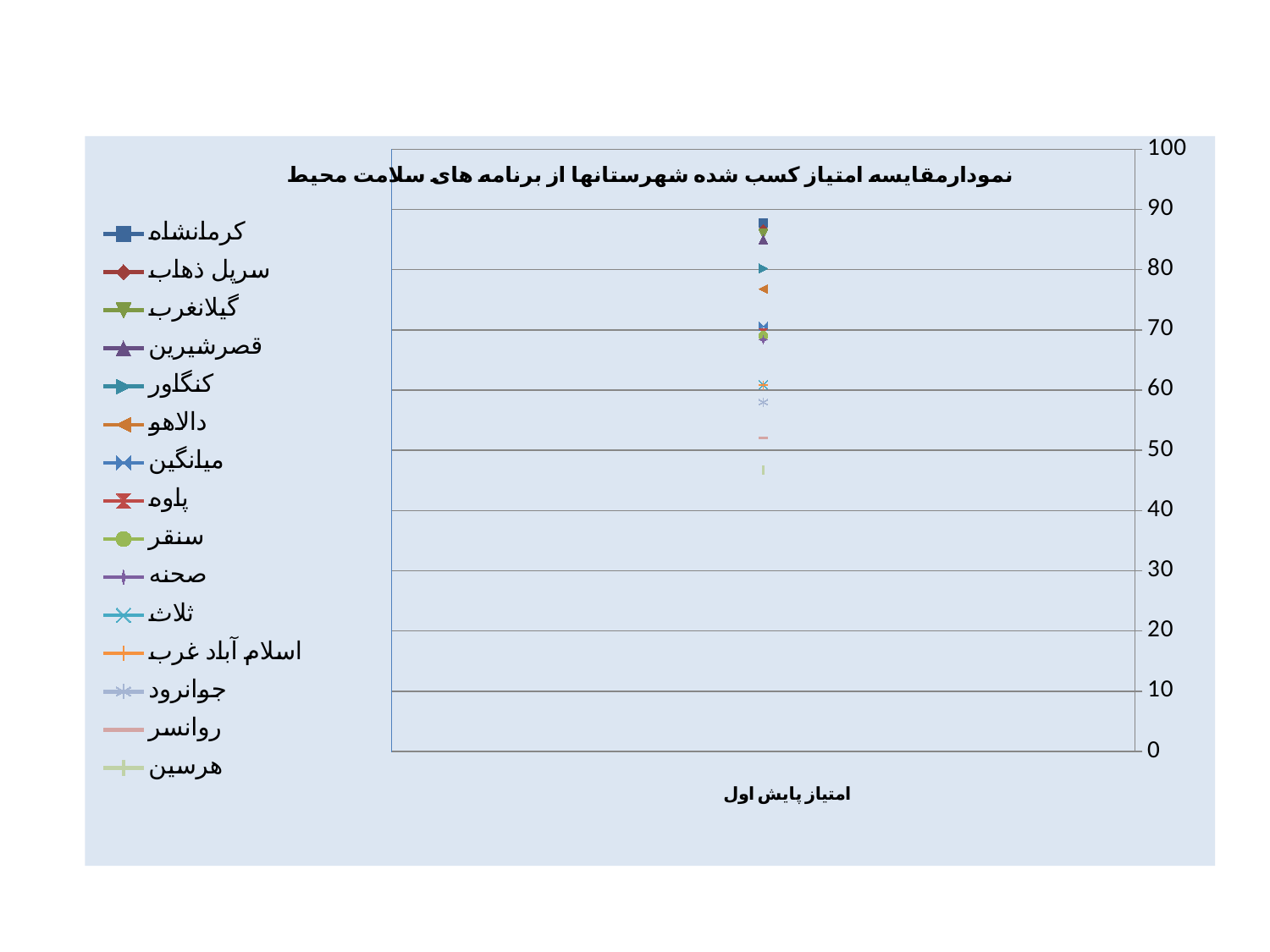
What kind of chart is shown on the slide? line chart Which series has the lowest value? هرسین What is the label of the x-axis category? امتیاز پایش اول Which is larger, the value for قصرشیرین or the value for دالاهو? قصرشیرین What is the title of the chart? نمودارمقایسه امتیاز کسب شده شهرستانها از برنامه های سلامت محیط How many categories are shown on the x axis? 1 Is the value for هرسین greater or less than 50? less Is the value for دالاهو greater or less than 70? greater Which is larger, the value for کنگاور or the value for هرسین? کنگاور Is the value for جوانرود greater or less than 70? less How many series does the legend list? 15